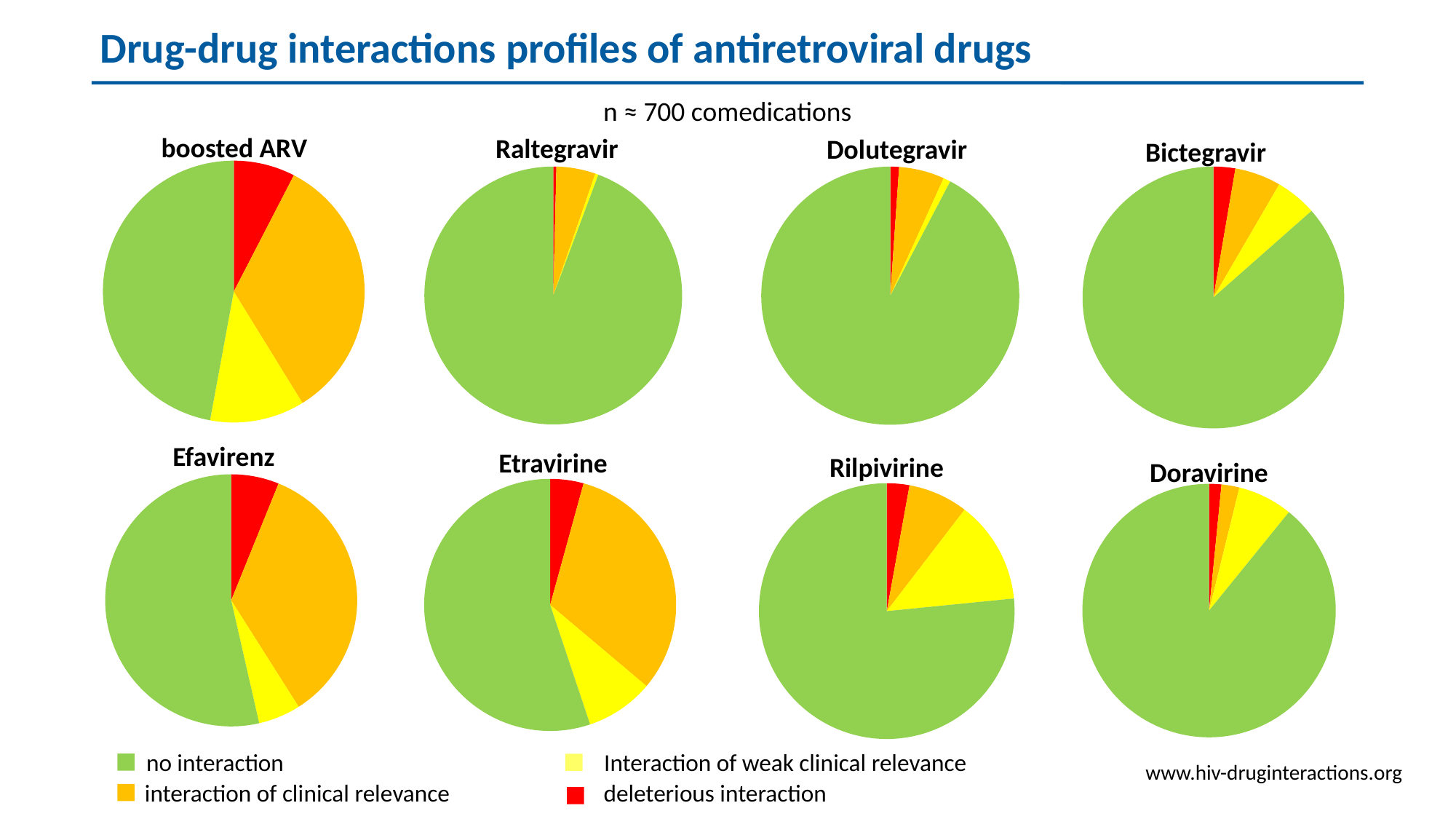
What is the title of the slide? Drug-drug interactions profiles of antiretroviral drugs In the Raltegravir chart, which category has the largest slice? no interaction In the Rilpivirine chart, which category has the smallest slice? deleterious interaction In the boosted ARV chart, which category has the smallest slice? deleterious interaction How many pie charts are shown on the slide? 8 Is the 'interaction of clinical relevance' slice larger in the Efavirenz chart or in the Dolutegravir chart? Efavirenz In the Rilpivirine chart, which category has the largest slice? no interaction Which colour represents 'deleterious interaction' in the legend? red How many categories does the legend list? 4 What kind of chart is used for the boosted ARV data? pie chart Is the 'no interaction' slice larger in the Raltegravir chart or in the boosted ARV chart? Raltegravir